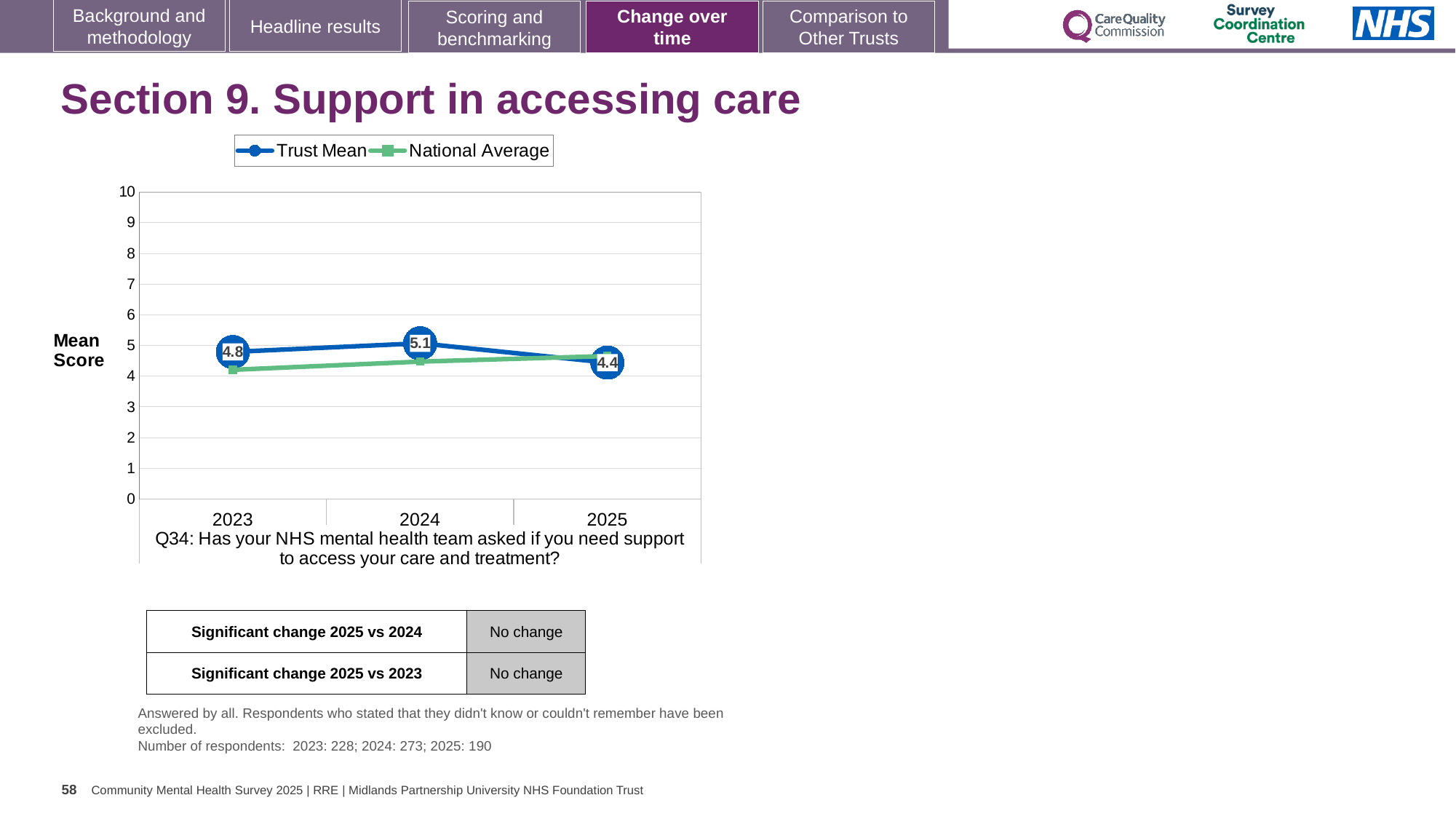
How many years are shown on the x axis? 3 In which year is the Trust Mean lowest? 2025 Is the National Average for 2023 greater or less than 5? less In 2023, which is higher: the Trust Mean or the National Average? Trust Mean What kind of chart is shown on the slide? Line chart What is the Trust Mean score for 2025? 4.4 What is the Trust Mean score for 2023? 4.8 In which year is the Trust Mean highest? 2024 What is the Trust Mean score for 2024? 5.1 Does the Trust Mean rise or fall from 2024 to 2025? Fall How many series does the legend list? 2 What is the difference between the Trust Mean in 2024 and in 2025? 0.7